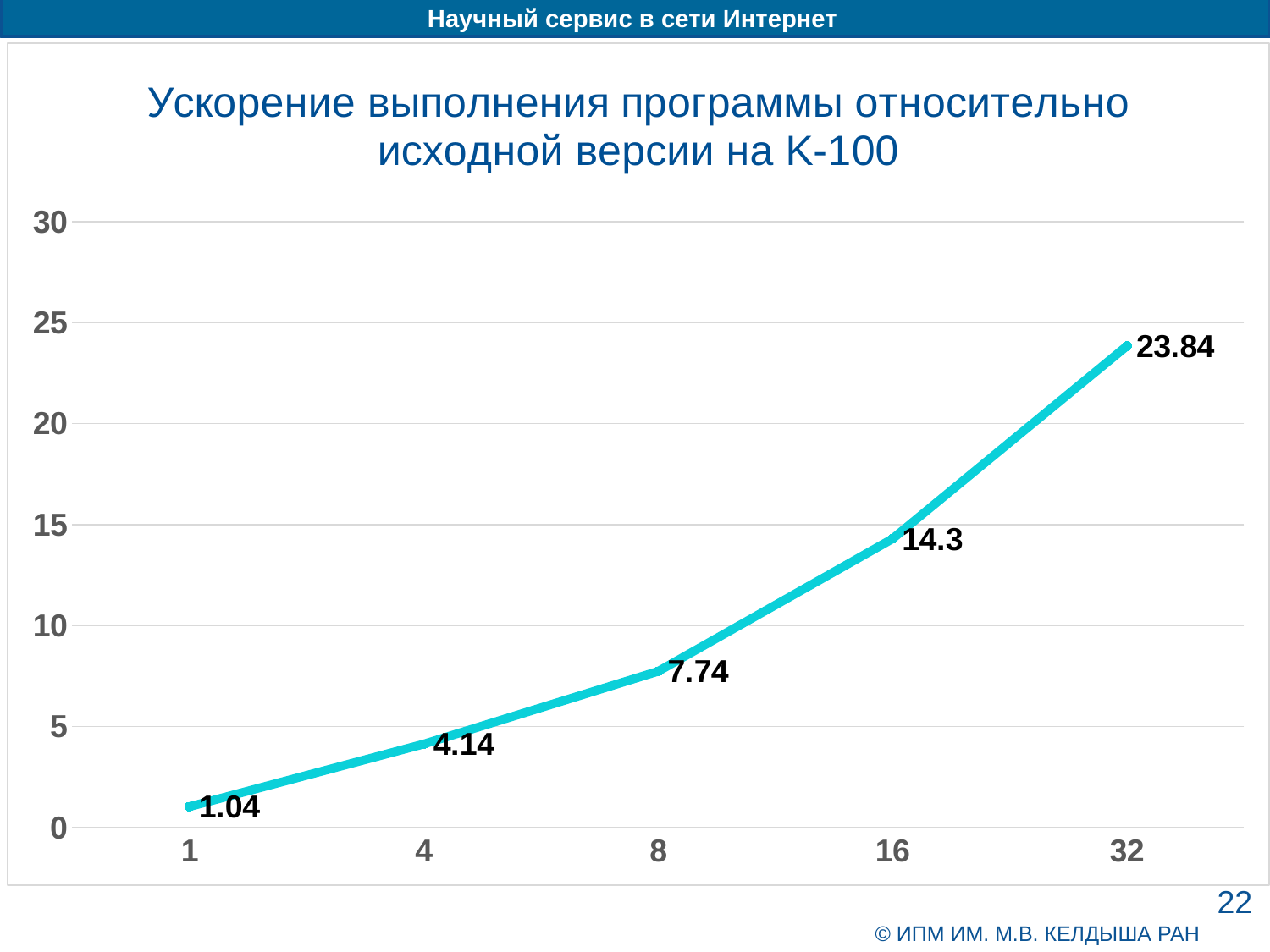
Do the values rise or fall as you move along the x axis from 1 to 32? rise What is the difference between the speedup at 32 and the speedup at 16? 9.54 What kind of chart is shown on the slide? line chart How many data points are plotted on the chart? 5 What is the speedup value at x = 1? 1.04 What is the speedup value at x = 32? 23.84 What is the difference between the speedup at 8 and the speedup at 4? 3.6 At which x-axis category is the speedup lowest? 1 What is the speedup value at x = 8? 7.74 What is the speedup value at x = 16? 14.3 At which x-axis category is the speedup highest? 32 Which is larger, the speedup at 4 or the speedup at 8? 8